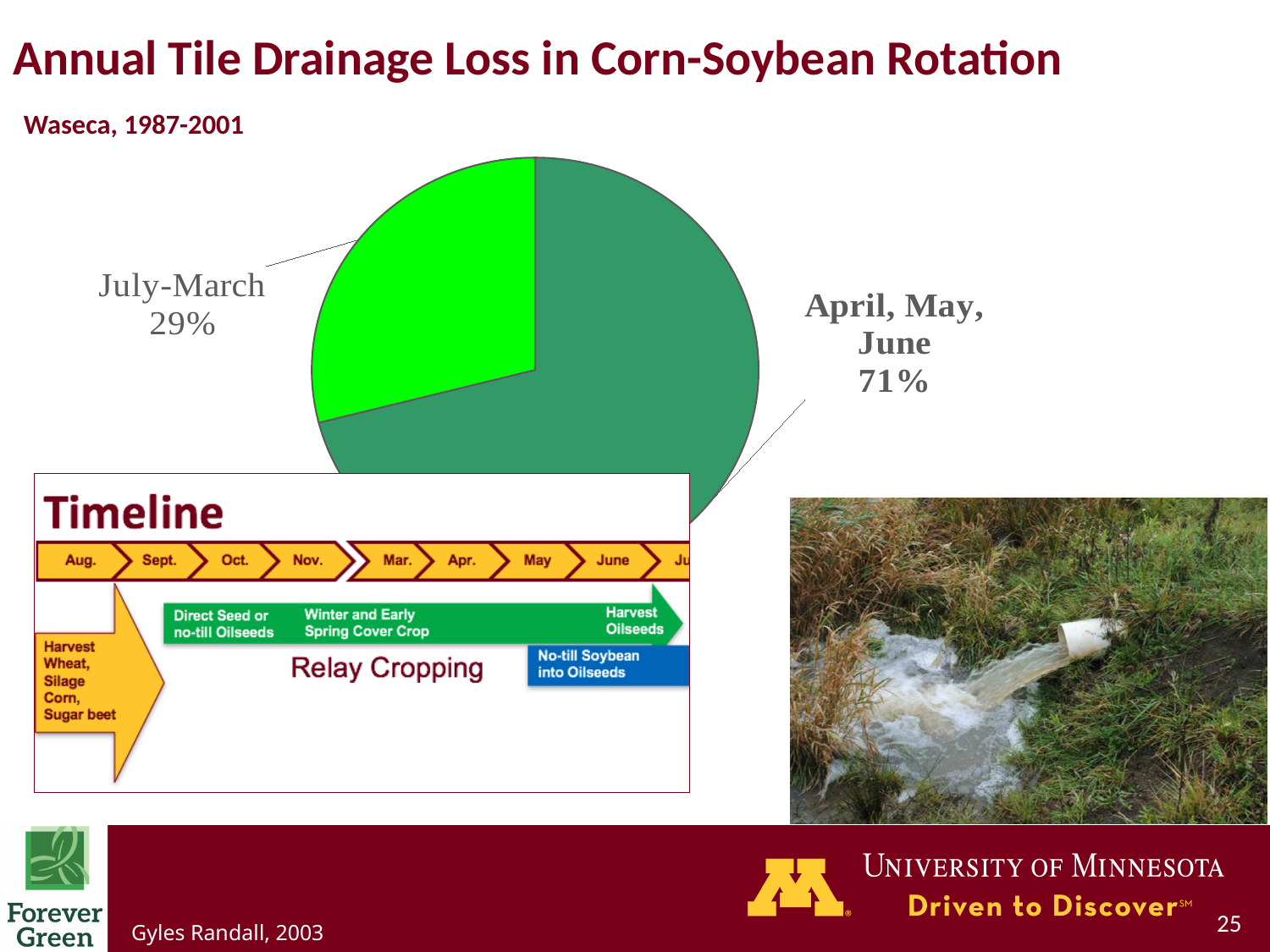
How many slices does the pie chart have? 2 What share of annual tile drainage loss occurs in April, May, June? 71% Which is larger: the share for July-March or the share for April, May, June? April, May, June Which period accounts for the largest share of annual tile drainage loss? April, May, June What kind of chart is shown on the slide? pie chart What is the title of the chart on the slide? Annual Tile Drainage Loss in Corn-Soybean Rotation What share of annual tile drainage loss occurs in July-March? 29% What location and years does the chart cover, according to the subtitle? Waseca, 1987-2001 Which period accounts for the smallest share of annual tile drainage loss? July-March What is the difference in percentage points between the April, May, June share and the July-March share? 42 Is the share for April, May, June greater or less than 50%? greater